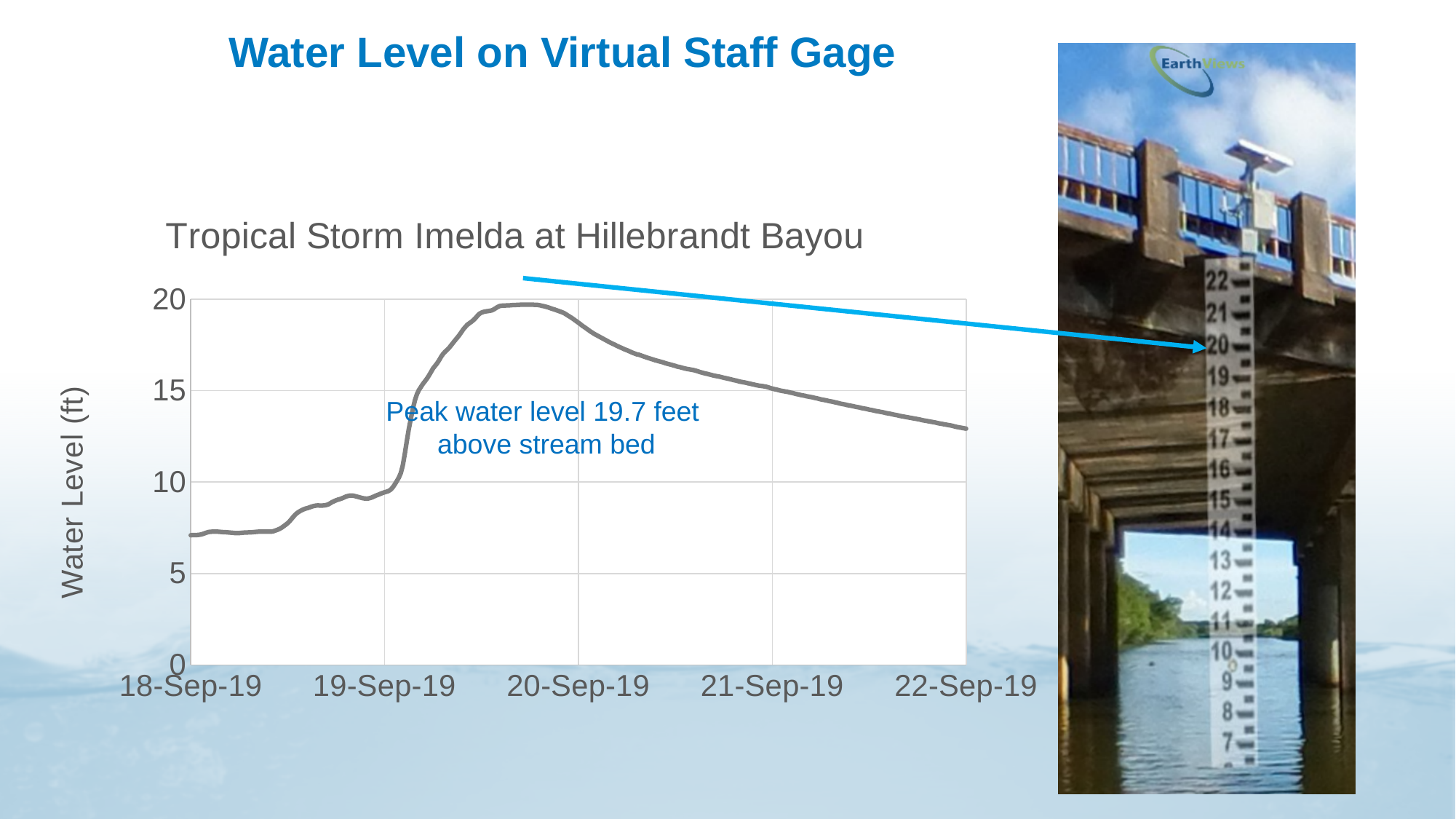
What is the title of the chart? Tropical Storm Imelda at Hillebrandt Bayou Is the water level at 22-Sep-19 greater or less than 10? greater Is the water level at 18-Sep-19 greater or less than 10? less Does the water level rise or fall between 20-Sep-19 and 22-Sep-19? fall How many date labels are shown on the horizontal axis? 5 Does the water level rise or fall between 19-Sep-19 and 20-Sep-19? rise What peak water level does the chart annotation report? 19.7 feet Is the water level at 20-Sep-19 greater or less than 15? greater What is the label of the vertical axis of the chart? Water Level (ft) Which date has the higher water level, 18-Sep-19 or 20-Sep-19? 20-Sep-19 What kind of chart is shown on the slide? Line chart